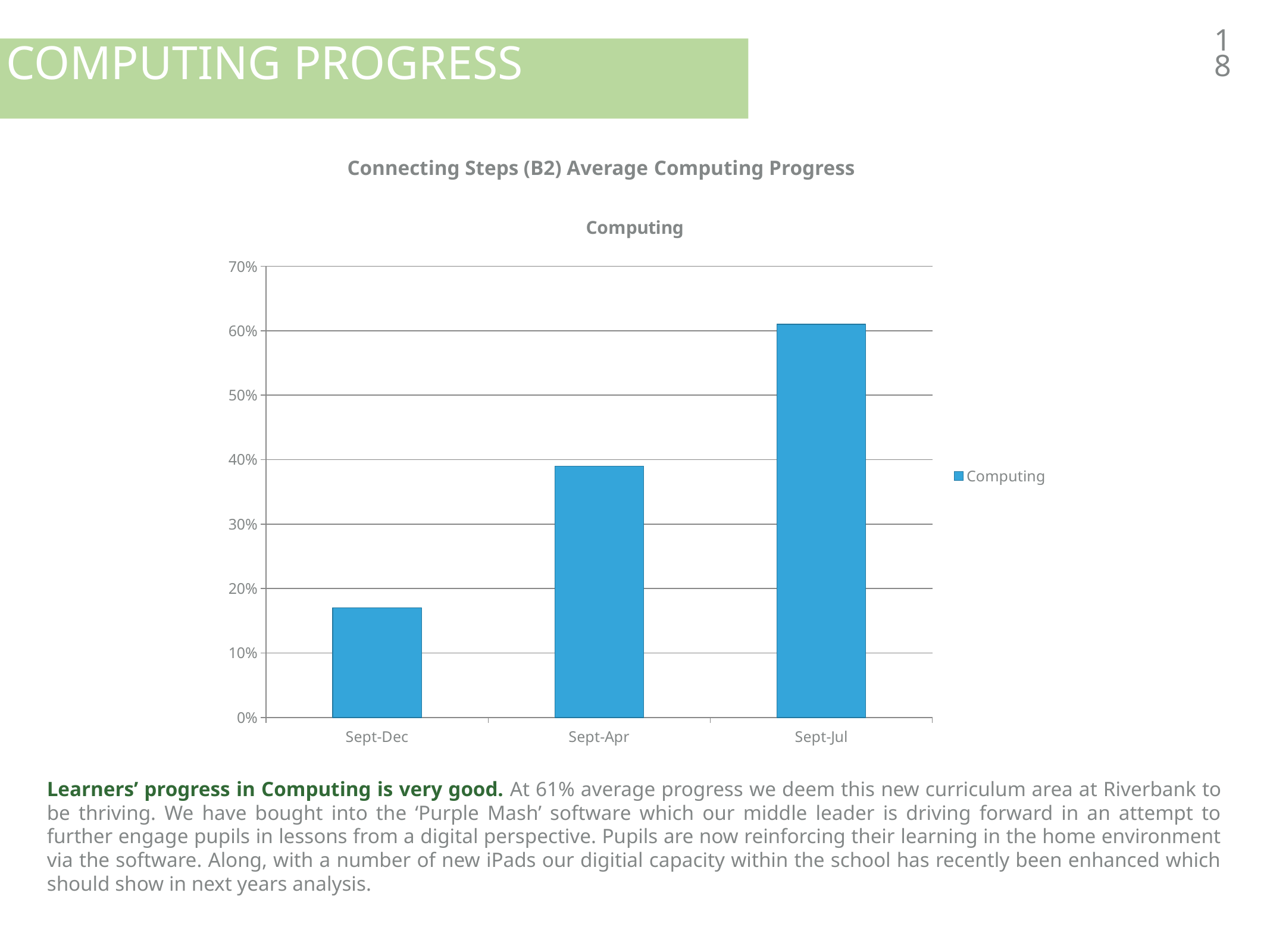
How many categories are shown on the x axis of the chart? 3 Is the value for Sept-Jul greater or less than 60%? greater Which period has the highest average computing progress? Sept-Jul How many series does the chart legend list? 1 Is the value for Sept-Dec greater or less than 20%? less Is the value for Sept-Apr greater or less than 30%? greater What is the title of the chart? Computing Which is larger, the value for Sept-Apr or the value for Sept-Dec? Sept-Apr Which period has the lowest average computing progress? Sept-Dec Do the values rise or fall from Sept-Dec to Sept-Jul? rise What kind of chart is shown on the slide? bar chart